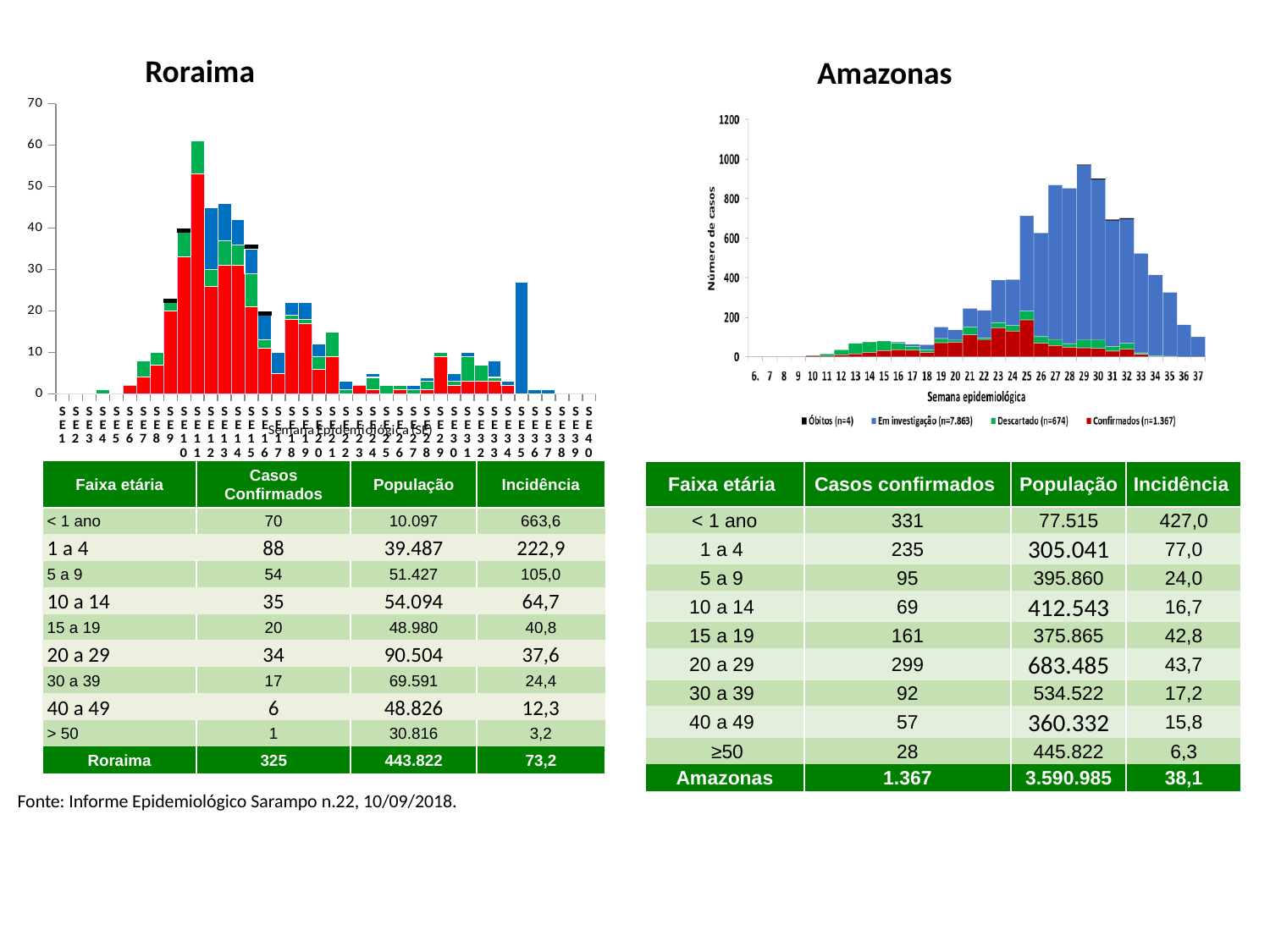
What is the highest tick value on the y axis of the Amazonas chart? 1200 In the Amazonas chart, which bar is taller: week 25 or week 29? week 29 In the Roraima chart, is the total for SE 12 greater or less than 50? less In the Roraima chart, is the total for SE 36 greater or less than 20? less What is the title of the y axis of the Amazonas chart? Número de casos In the Amazonas chart, which epidemiological week has the tallest bar? 29 How many series does the legend of the Amazonas chart list? 4 In the Amazonas chart, is the total for week 10 greater or less than 200? less In the Roraima chart, which epidemiological week has the tallest bar? SE11 What kind of chart is the Roraima chart? bar chart In the Amazonas chart, do the bar totals rise or fall from week 29 to week 37? fall